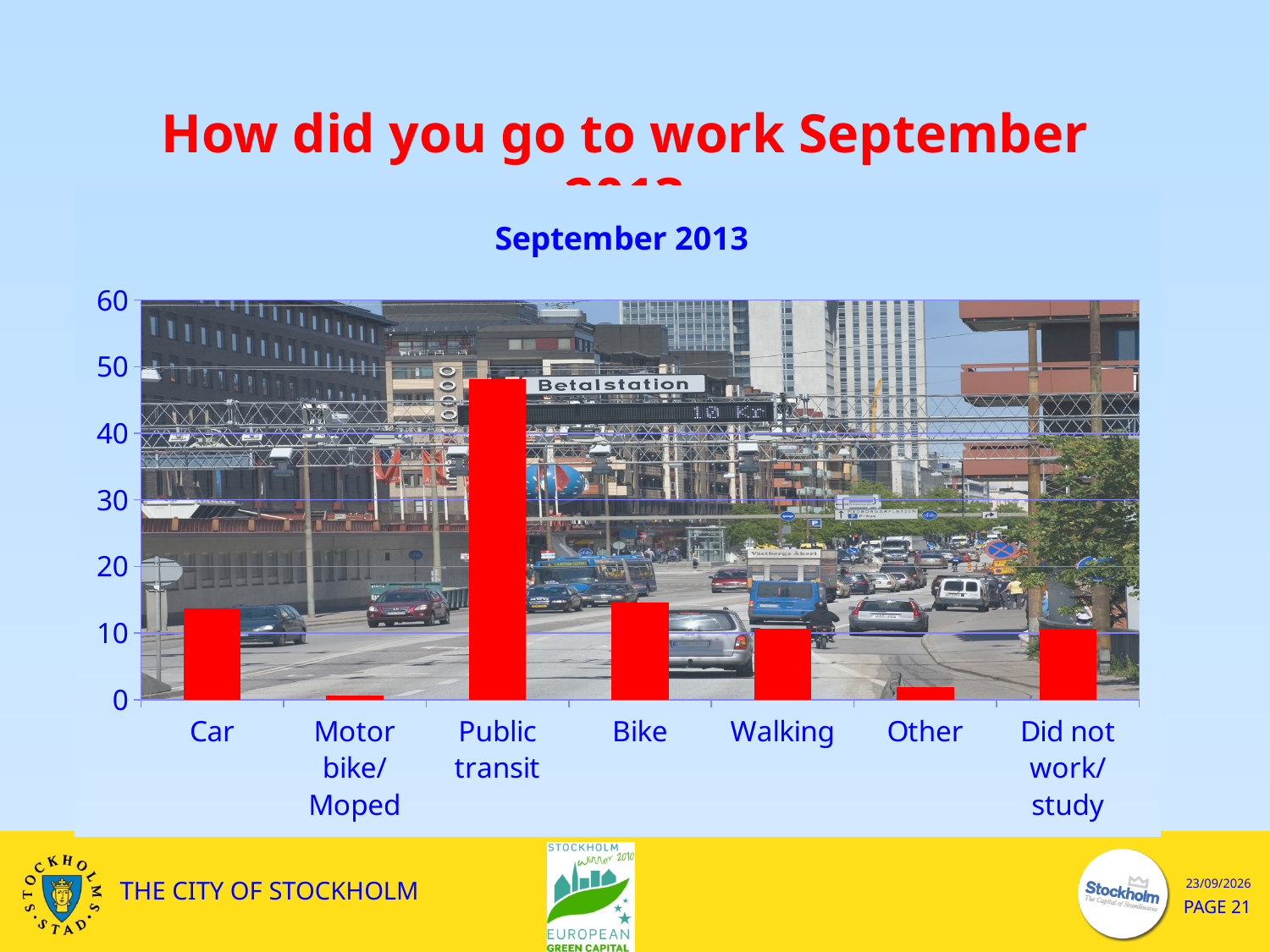
Is the value for Car greater or less than 20? less Is the value for Motor bike/Moped greater or less than 10? less What colour are the bars in the chart? red Which category has the highest value in the chart? Public transit Which is larger, the value for Bike or the value for Other? Bike How many categories are shown on the x axis of the chart? 7 Is the value for Other greater or less than 10? less Which is larger, the value for Public transit or the value for Car? Public transit What kind of chart is shown on the slide? bar chart What is the title shown directly above the chart? September 2013